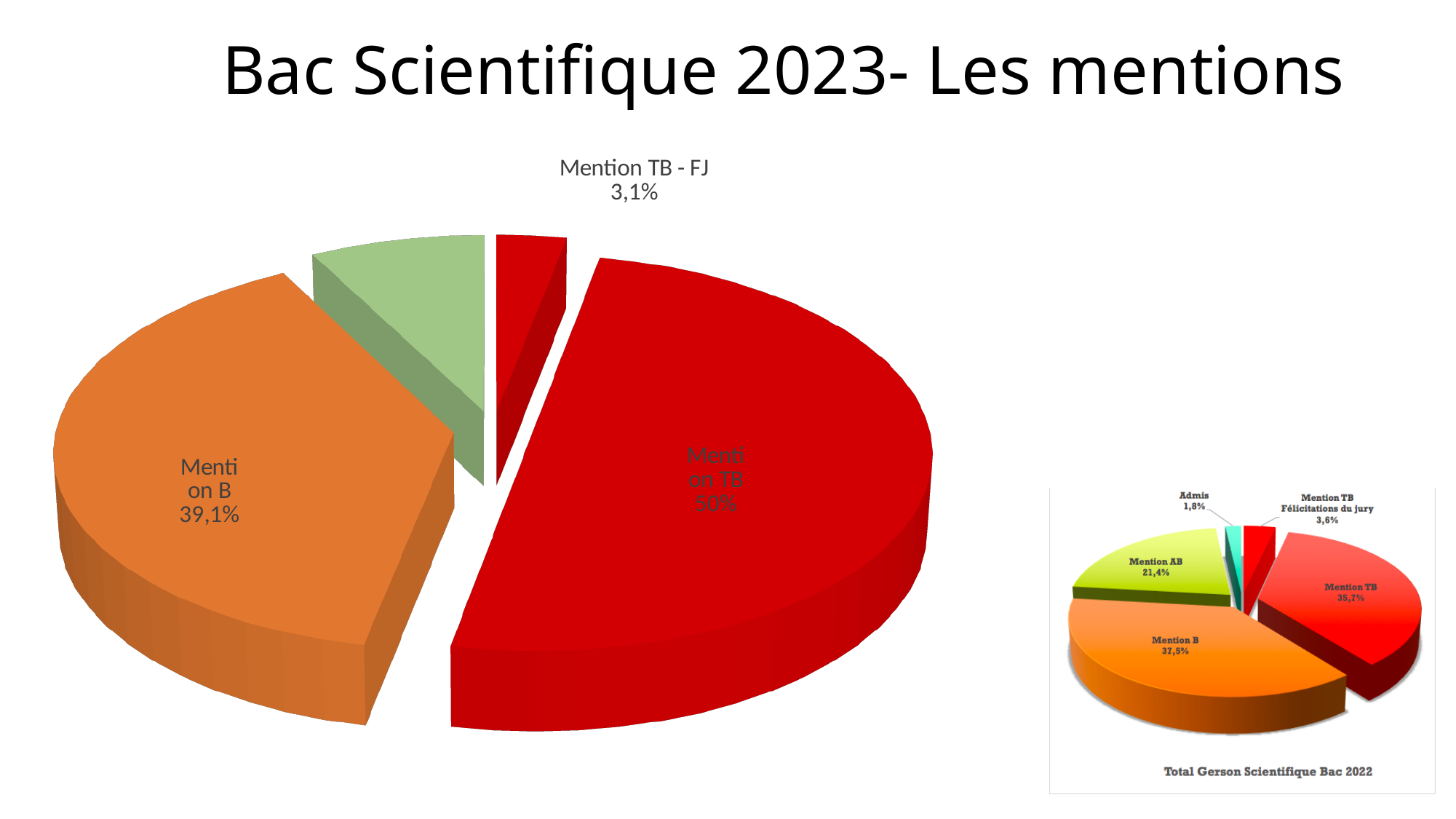
In the large pie chart on the left, what is the difference between the shares of Mention TB and Mention B? 10,9% In the large pie chart on the left, what share is shown for Mention B? 39,1% In the small inset chart titled Total Gerson Scientifique Bac 2022, what share is shown for Mention AB? 21,4% In the large pie chart on the left, which labelled slice is the smallest? Mention TB - FJ In the small inset chart titled Total Gerson Scientifique Bac 2022, which is larger, Mention B or Mention TB? Mention B In the large pie chart on the left, what share is shown for Mention TB? 50% In the small inset chart titled Total Gerson Scientifique Bac 2022, what share is shown for Admis? 1,8% What kind of chart is the large chart on the left of the slide? pie chart In the large pie chart on the left, which labelled slice is the largest? Mention TB In the large pie chart on the left, what share is shown for Mention TB - FJ? 3,1% What is the title of the small inset chart on the right of the slide? Total Gerson Scientifique Bac 2022 How many slices does the large pie chart on the left have? 4